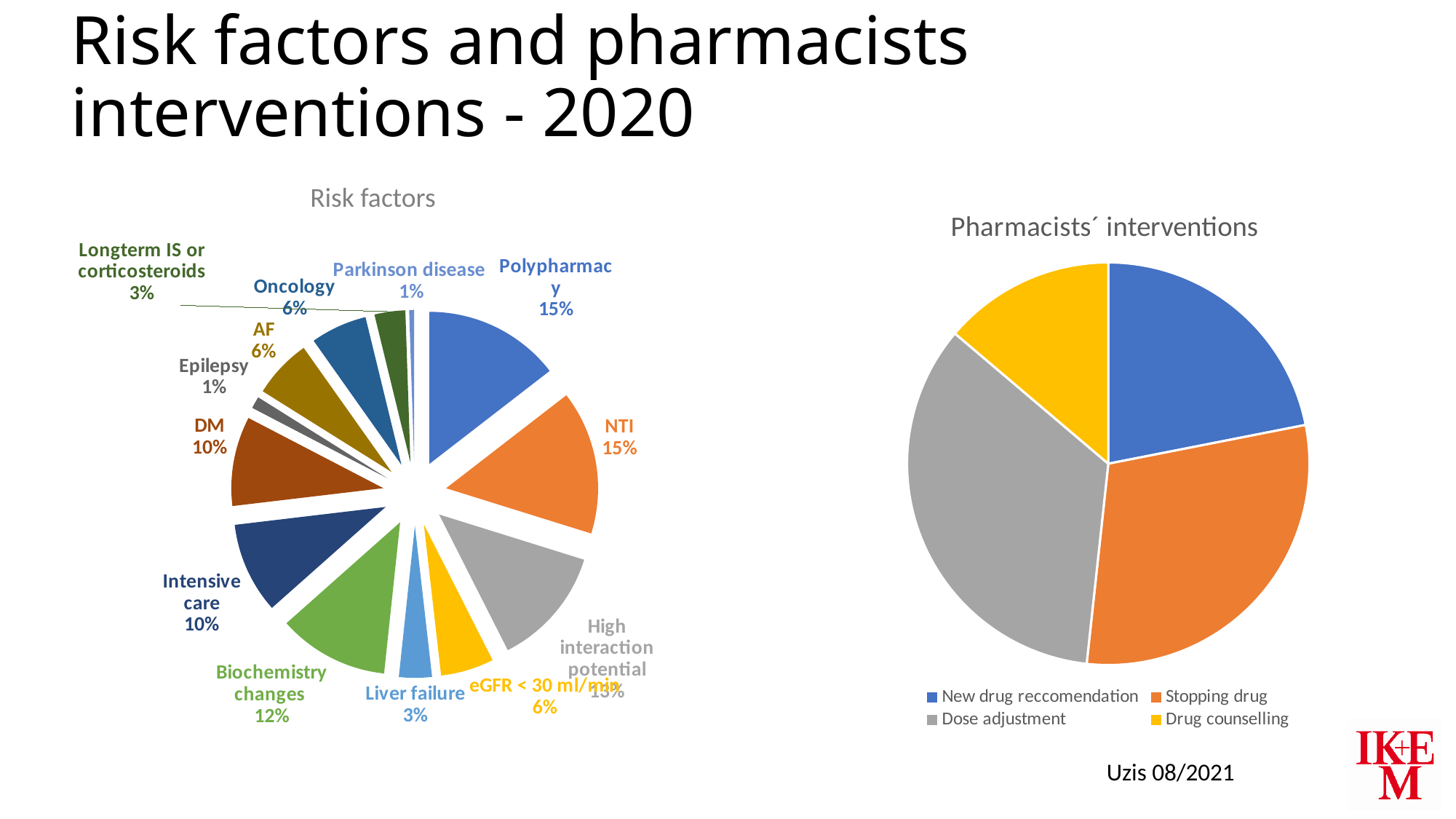
In the Risk factors pie chart, what percentage is shown for Intensive care? 10% In the Pharmacists´ interventions pie chart, which category has the smallest slice? Drug counselling In the Risk factors pie chart, what percentage is shown for Biochemistry changes? 12% In the Risk factors pie chart, what is the difference in percentage points between DM and Liver failure? 7 In the Risk factors pie chart, which is larger: DM or Liver failure? DM How many categories are shown in the Risk factors pie chart? 13 In the Pharmacists´ interventions pie chart, which slice is larger: Stopping drug or New drug reccomendation? Stopping drug How many entries does the legend of the Pharmacists´ interventions chart list? 4 What kind of chart is the Risk factors chart? Pie chart In the Pharmacists´ interventions pie chart, what colour represents Dose adjustment? Grey In the Risk factors pie chart, what percentage is shown for Polypharmacy? 15% In the Risk factors pie chart, what percentage is shown for Oncology? 6%